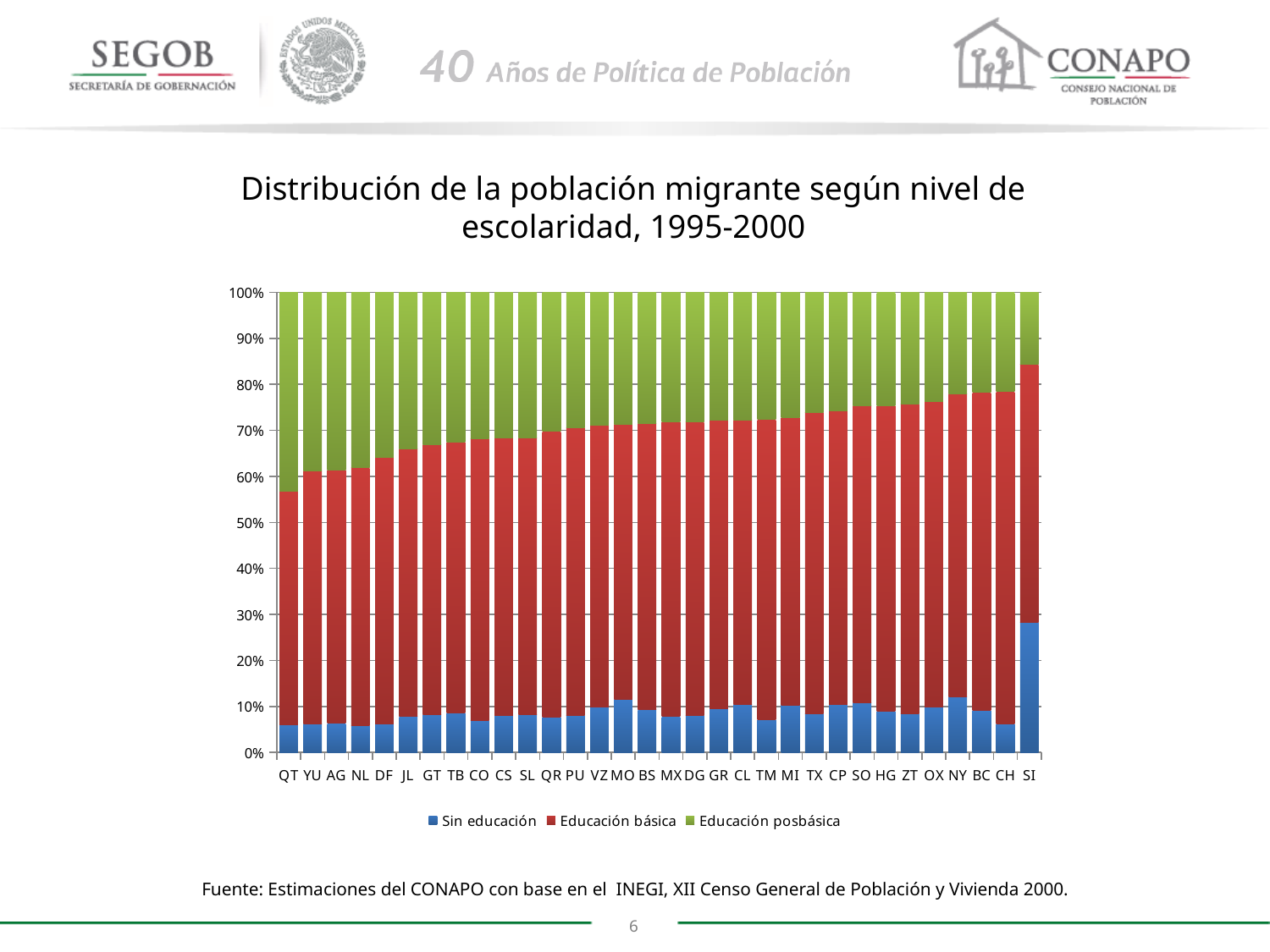
Which category has the largest Educación posbásica share? QT Is the Educación posbásica share for SI greater or less than 20%? less Which has the larger Sin educación share, MO or QT? MO What kind of chart is shown on the slide? Stacked bar chart Moving from QT on the left to SI on the right, does the Educación posbásica share rise or fall? fall Which colour represents Sin educación in the legend? Blue Is the Sin educación share for SI greater or less than 20%? greater How many state categories are shown along the x axis? 32 Is the Educación posbásica share for QT greater or less than 40%? greater Which category has the largest Sin educación share? SI Which category has the smallest Educación posbásica share? SI How many series does the legend list? 3